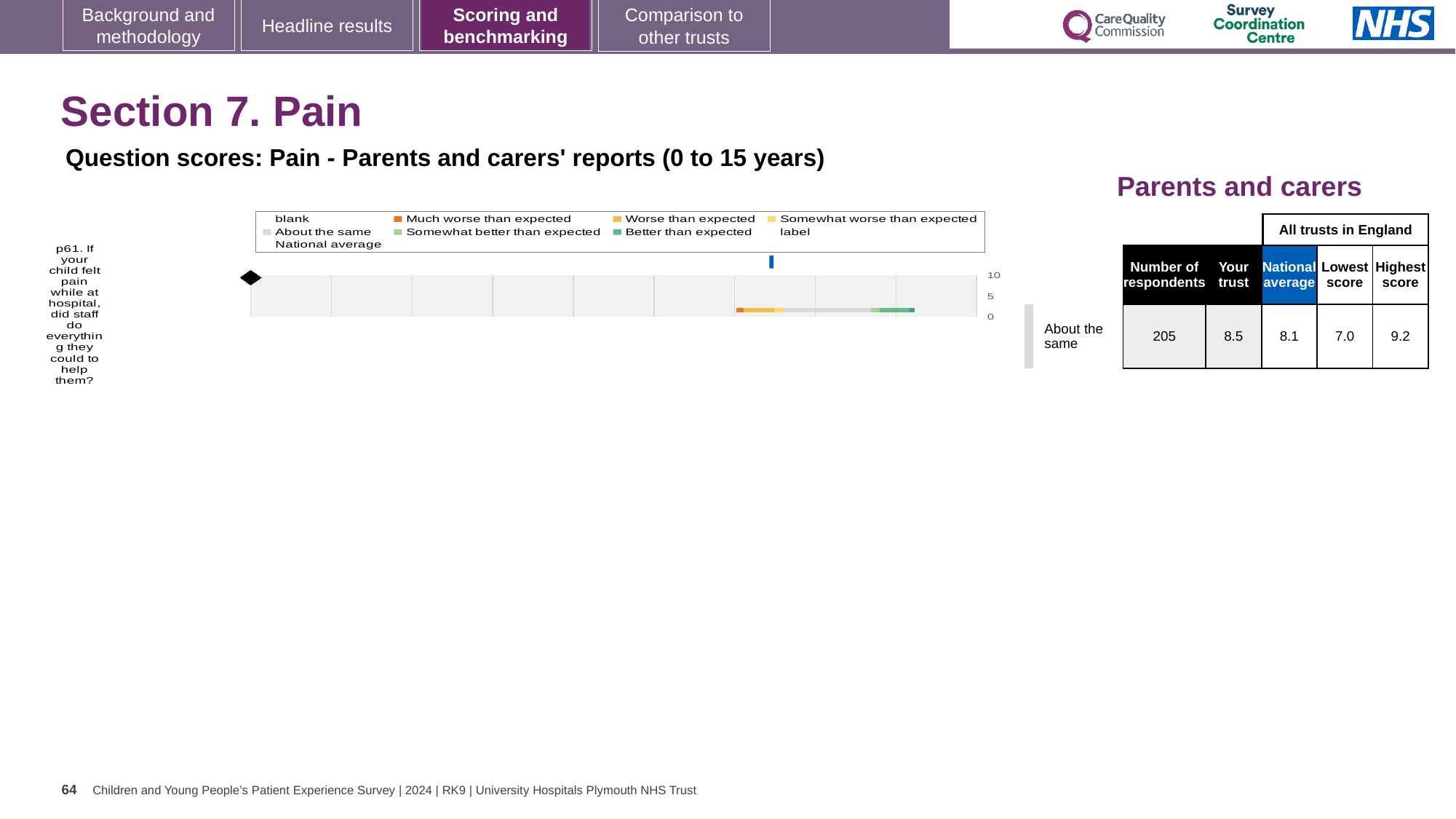
How many respondents answered question p61? 205 What colour does the legend use for 'Much worse than expected'? orange Which benchmark category is question p61 assigned to? About the same Which is higher for question p61, the 'Your trust' score or the national average? Your trust What is the national average score for question p61? 8.1 What is the highest value shown on the chart's score axis? 10 What kind of chart is shown on the slide? bar chart What is the difference between the highest score and the lowest score across all trusts in England for question p61? 2.2 What is the difference between the 'Your trust' score and the national average for question p61? 0.4 How many entries does the chart legend list? 9 How many survey questions are plotted in the chart? 1 What is the 'Your trust' score for question p61 about staff helping a child in pain? 8.5